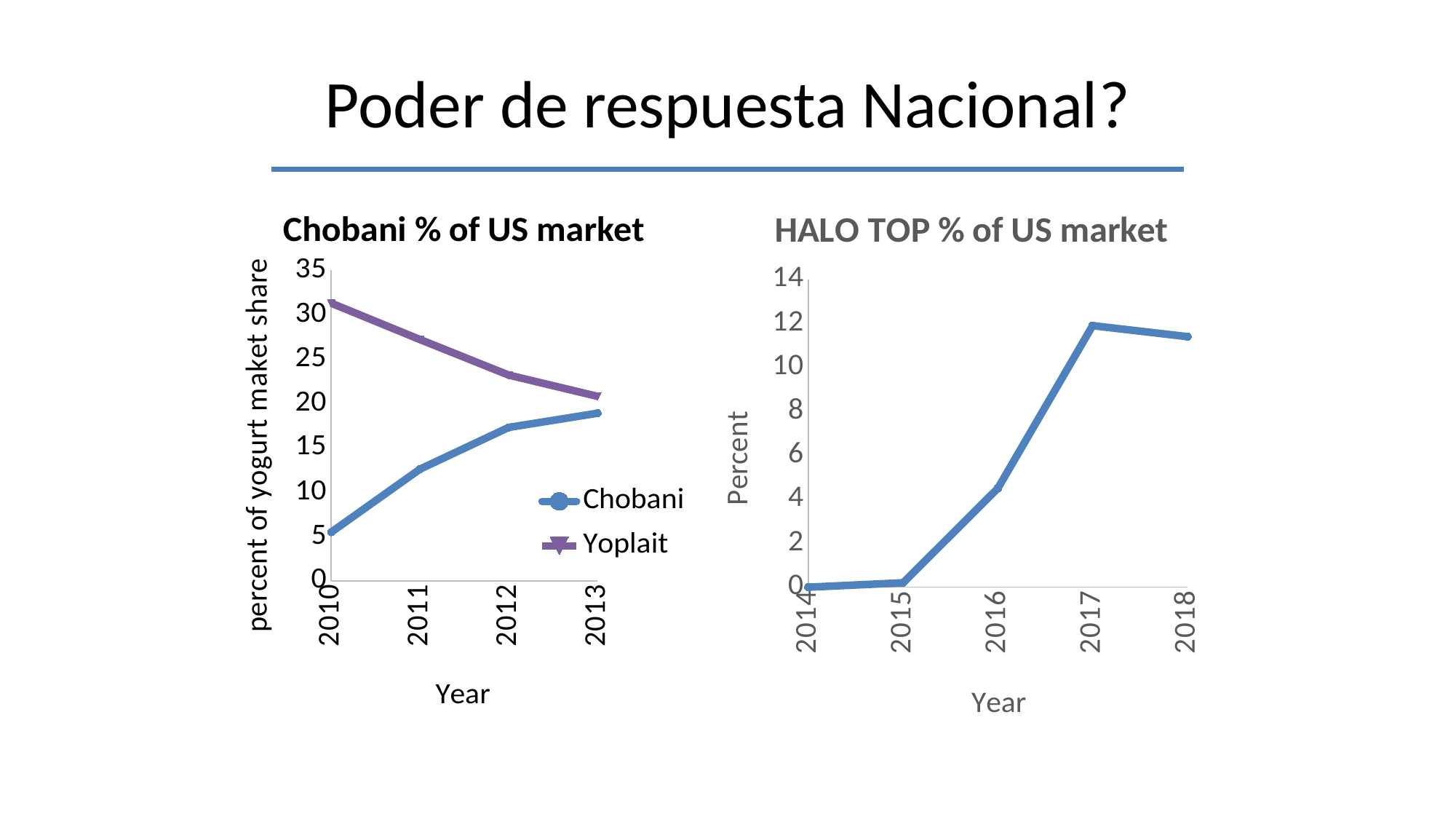
In the 'Chobani % of US market' chart, does the Yoplait series rise or fall from 2010 to 2013? fall How many series does the legend of the 'Chobani % of US market' chart list? 2 In the 'Chobani % of US market' chart, does the Chobani series rise or fall from 2010 to 2013? rise What kind of chart is the 'Chobani % of US market' chart? line chart In the 'HALO TOP % of US market' chart, which year has the highest value? 2017 In the 'Chobani % of US market' chart, how many years are shown on the x axis? 4 In the 'Chobani % of US market' chart, which series has the higher value in 2013, Chobani or Yoplait? Yoplait What is the y-axis label of the 'HALO TOP % of US market' chart? Percent In the 'Chobani % of US market' chart, is the Chobani value for 2010 greater or less than 10? less In the 'Chobani % of US market' chart, is the Yoplait value for 2010 greater or less than 30? greater In the 'HALO TOP % of US market' chart, is the value for 2016 greater or less than 6? less In the 'HALO TOP % of US market' chart, how many years are shown on the x axis? 5